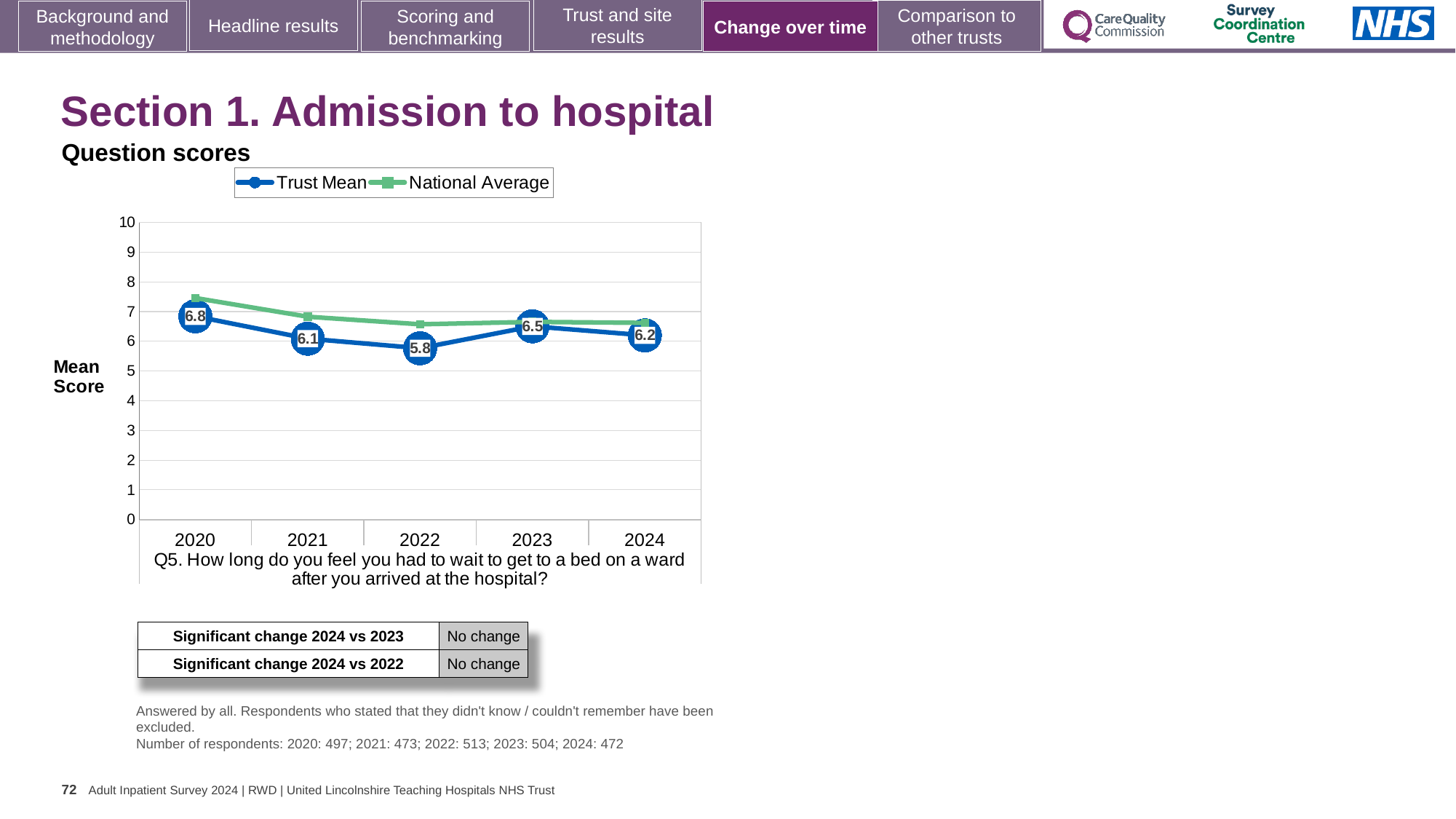
In which year is the Trust Mean score lowest? 2022 In which year is the Trust Mean score highest? 2020 Does the Trust Mean score rise or fall from 2020 to 2022? Fall What is the Trust Mean score for 2022? 5.8 What is the Trust Mean score for 2024? 6.2 What kind of chart is shown on the slide? Line chart What is the difference between the Trust Mean scores for 2020 and 2022? 1.0 What is the Trust Mean score for 2020? 6.8 Which is larger, the Trust Mean score for 2023 or for 2024? 2023 How many years are plotted on the x axis? 5 Is the National Average value for 2020 greater or less than 7? greater How many series does the legend list? 2